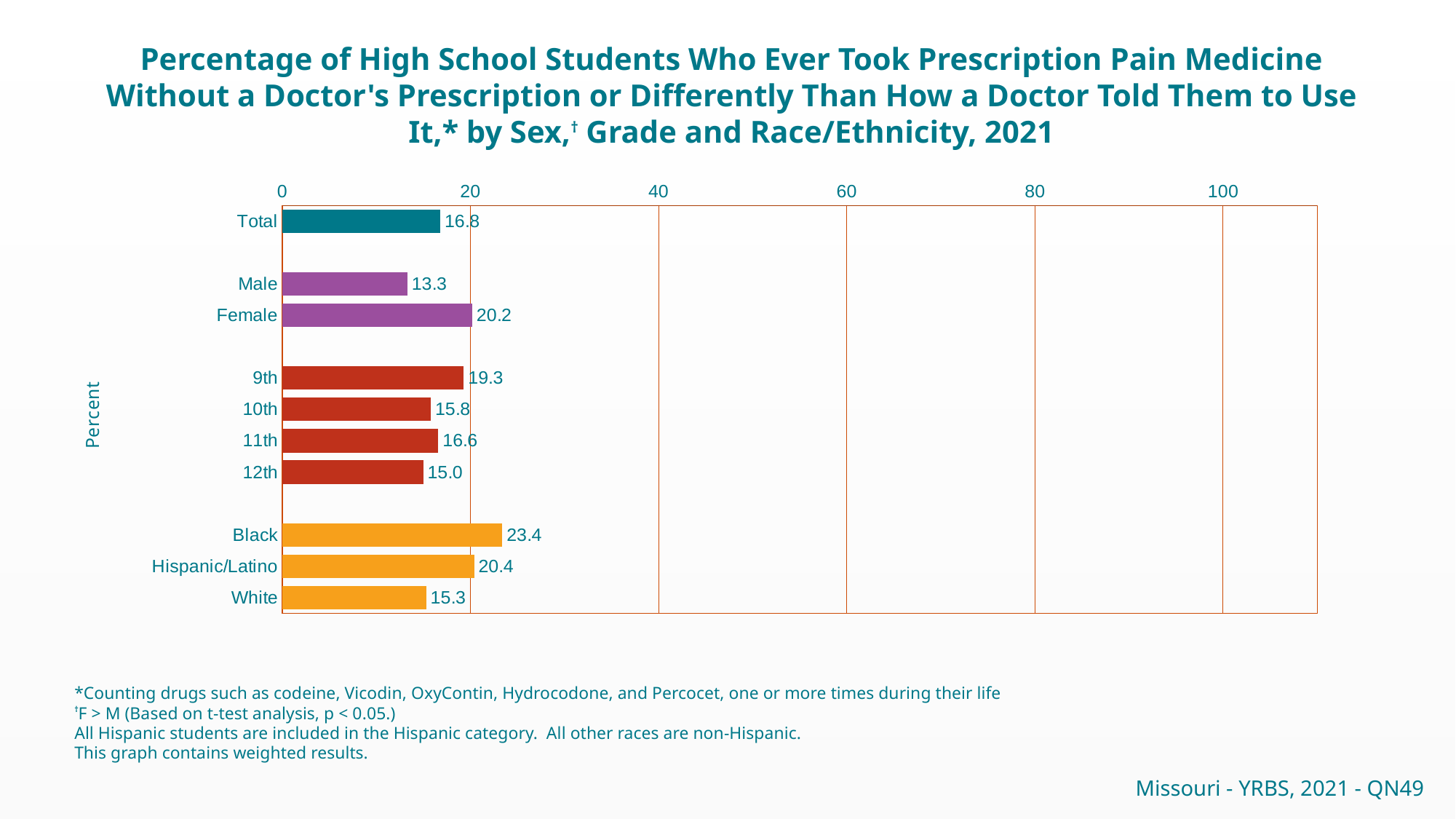
What is the value for Total? 16.8 Which is larger, the value for 9th grade or the value for 10th grade? 9th What is the label on the vertical axis? Percent Which category has the highest value? Black How many categories are plotted in the chart? 11 What is the value for Hispanic/Latino? 20.4 What is the value for 12th grade? 15.0 What is the value for Female? 20.2 Which category has the lowest value? Male What kind of chart is shown on the slide? bar chart What is the difference between the Female and Male values? 6.9 Is the value for Black greater or less than 20? greater